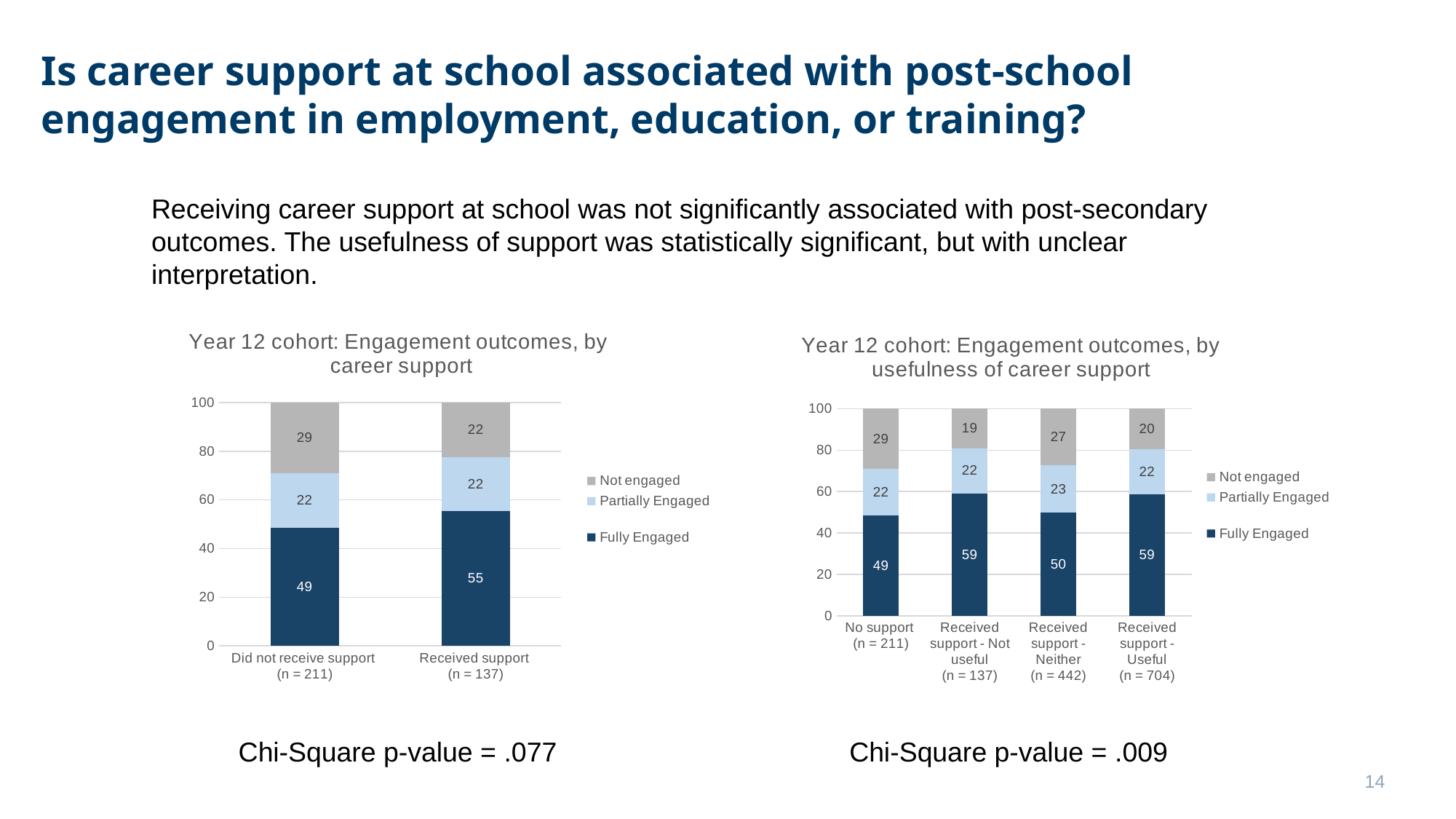
In the chart 'Year 12 cohort: Engagement outcomes, by career support', what is the difference in Fully Engaged values between 'Received support' and 'Did not receive support'? 6 In the chart 'Year 12 cohort: Engagement outcomes, by career support', what is the Not engaged value for 'Did not receive support (n = 211)'? 29 In the chart 'Year 12 cohort: Engagement outcomes, by career support', how many series does the legend list? 3 In the chart 'Year 12 cohort: Engagement outcomes, by usefulness of career support', which category has the highest Not engaged value? No support (n = 211) In the chart 'Year 12 cohort: Engagement outcomes, by usefulness of career support', which category has the lowest Not engaged value? Received support - Not useful (n = 137) In the chart 'Year 12 cohort: Engagement outcomes, by usefulness of career support', is the Fully Engaged value for 'No support' larger or smaller than for 'Received support - Not useful'? smaller In the chart 'Year 12 cohort: Engagement outcomes, by career support', what is the Fully Engaged value for 'Received support (n = 137)'? 55 In the chart 'Year 12 cohort: Engagement outcomes, by career support', what is the total of the stacked bar for 'Did not receive support (n = 211)'? 100 In the chart 'Year 12 cohort: Engagement outcomes, by usefulness of career support', what is the Partially Engaged value for 'Received support - Neither (n = 442)'? 23 What type of chart is 'Year 12 cohort: Engagement outcomes, by usefulness of career support'? Stacked bar chart In the chart 'Year 12 cohort: Engagement outcomes, by usefulness of career support', how many categories are shown on the x axis? 4 In the chart 'Year 12 cohort: Engagement outcomes, by usefulness of career support', what is the Fully Engaged value for 'Received support - Useful (n = 704)'? 59